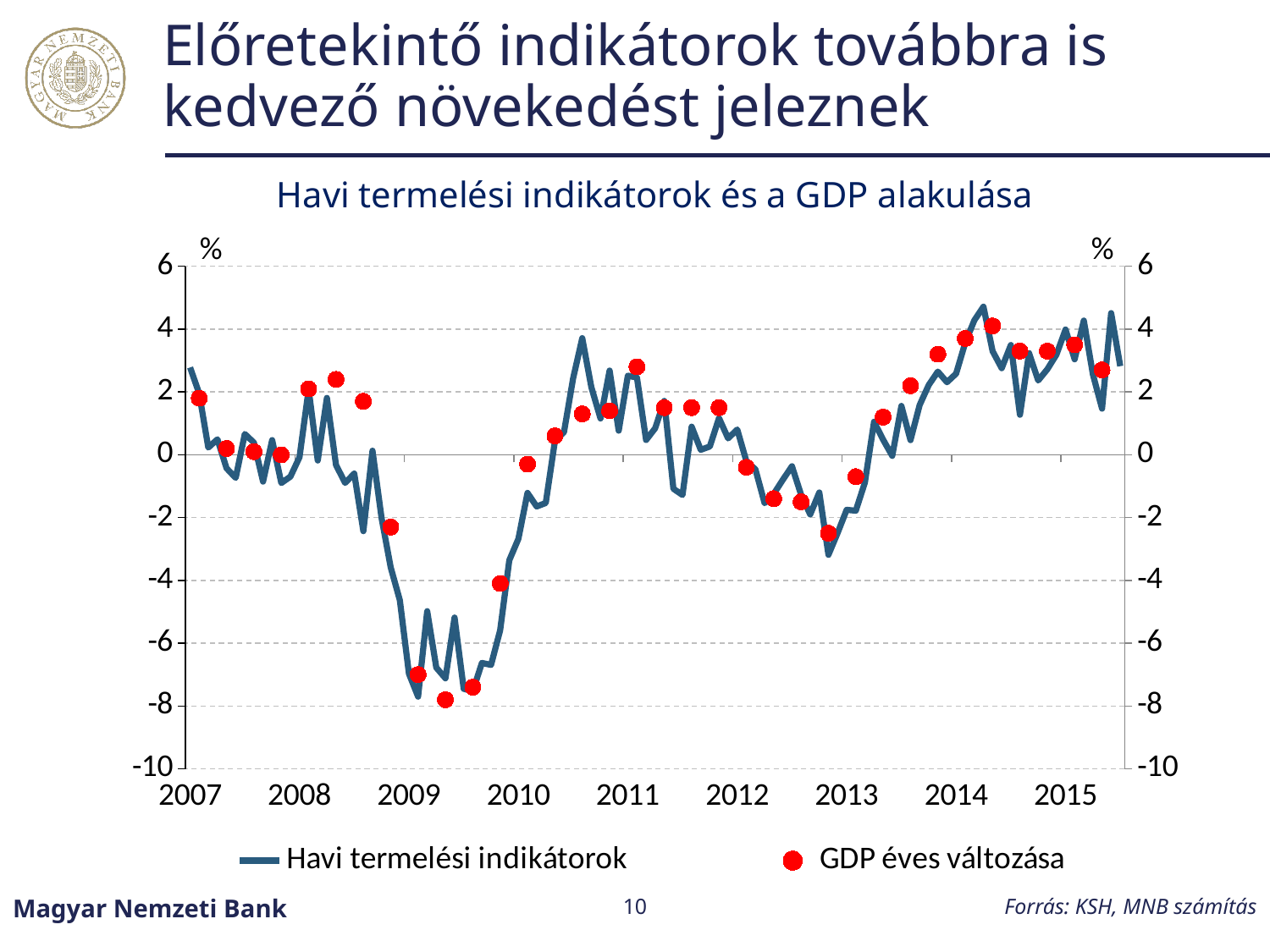
What kind of chart is shown on the slide? line chart Is the lowest value of GDP éves változása greater or less than -6? less Which is larger: GDP éves változása in 2009 or in 2014? 2014 How many year labels are shown on the x axis? 9 Is the first GDP éves változása point in 2007 greater or less than 0? greater Between 2012 and 2014, does Havi termelési indikátorok generally rise or fall? rise What is the title of the chart? Havi termelési indikátorok és a GDP alakulása Is the lowest value of Havi termelési indikátorok greater or less than -6? less What are the two series named in the legend? Havi termelési indikátorok; GDP éves változása In which year does GDP éves változása reach its lowest value? 2009 How many series does the legend list? 2